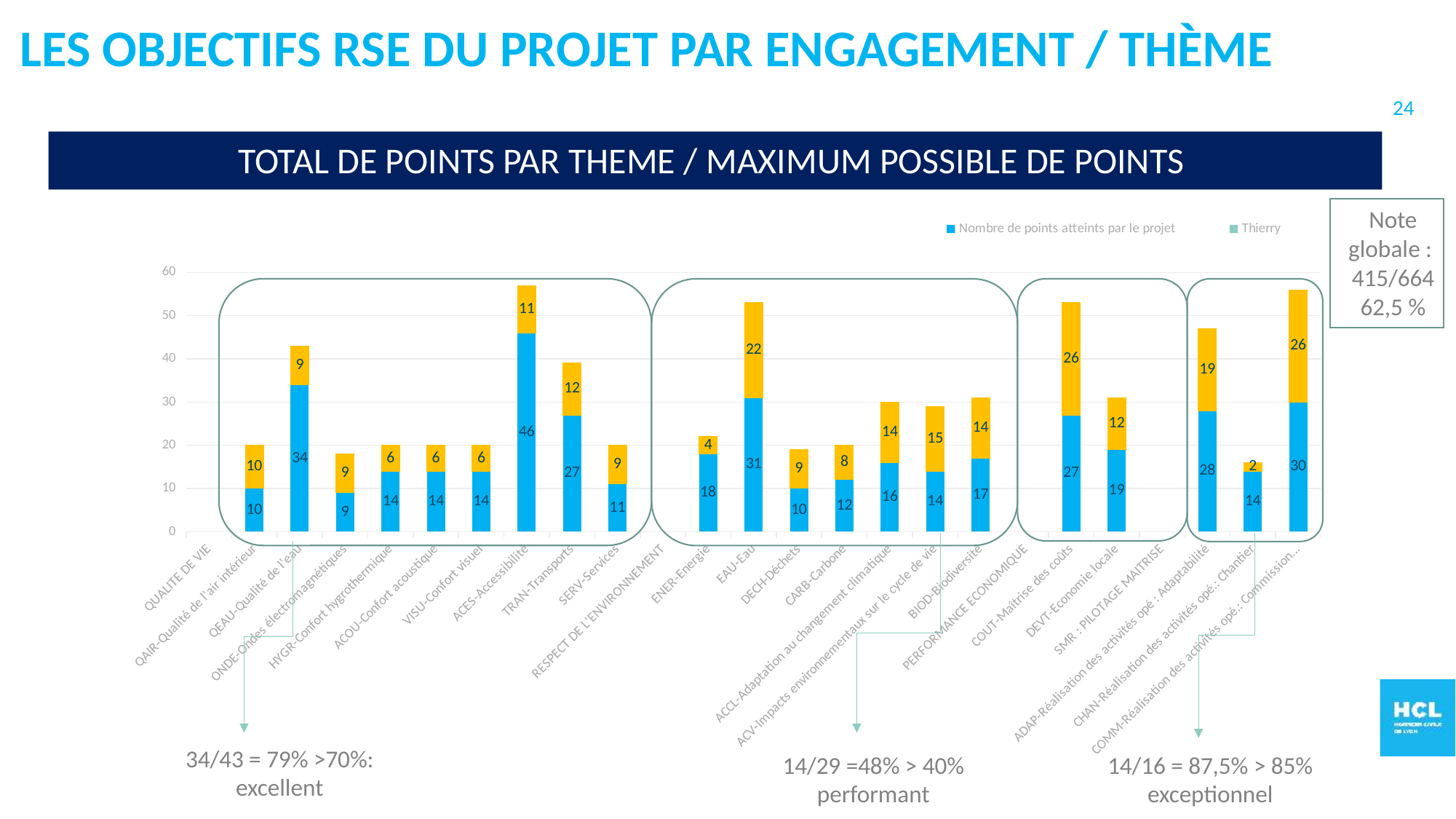
What is the title shown in the banner above the chart? TOTAL DE POINTS PAR THEME / MAXIMUM POSSIBLE DE POINTS Which category has the highest value for 'Nombre de points atteints par le projet'? ACES-Accessibilité What kind of chart is shown on the slide? stacked bar chart What is the difference between the 'Nombre de points atteints par le projet' values for TRAN-Transports and SERV-Services? 16 What is the value of 'Nombre de points atteints par le projet' for COUT-Maîtrise des coûts? 27 Which category has the lowest value for 'Nombre de points atteints par le projet'? ONDE-Ondes électromagnétiques How many series does the legend list? 2 What is the value of 'Nombre de points atteints par le projet' for ACES-Accessibilité? 46 What is the total of the stacked bar for CHAN-Réalisation des activités opé.: Chantier? 16 What is the total of the stacked bar for QEAU-Qualité de l'eau? 43